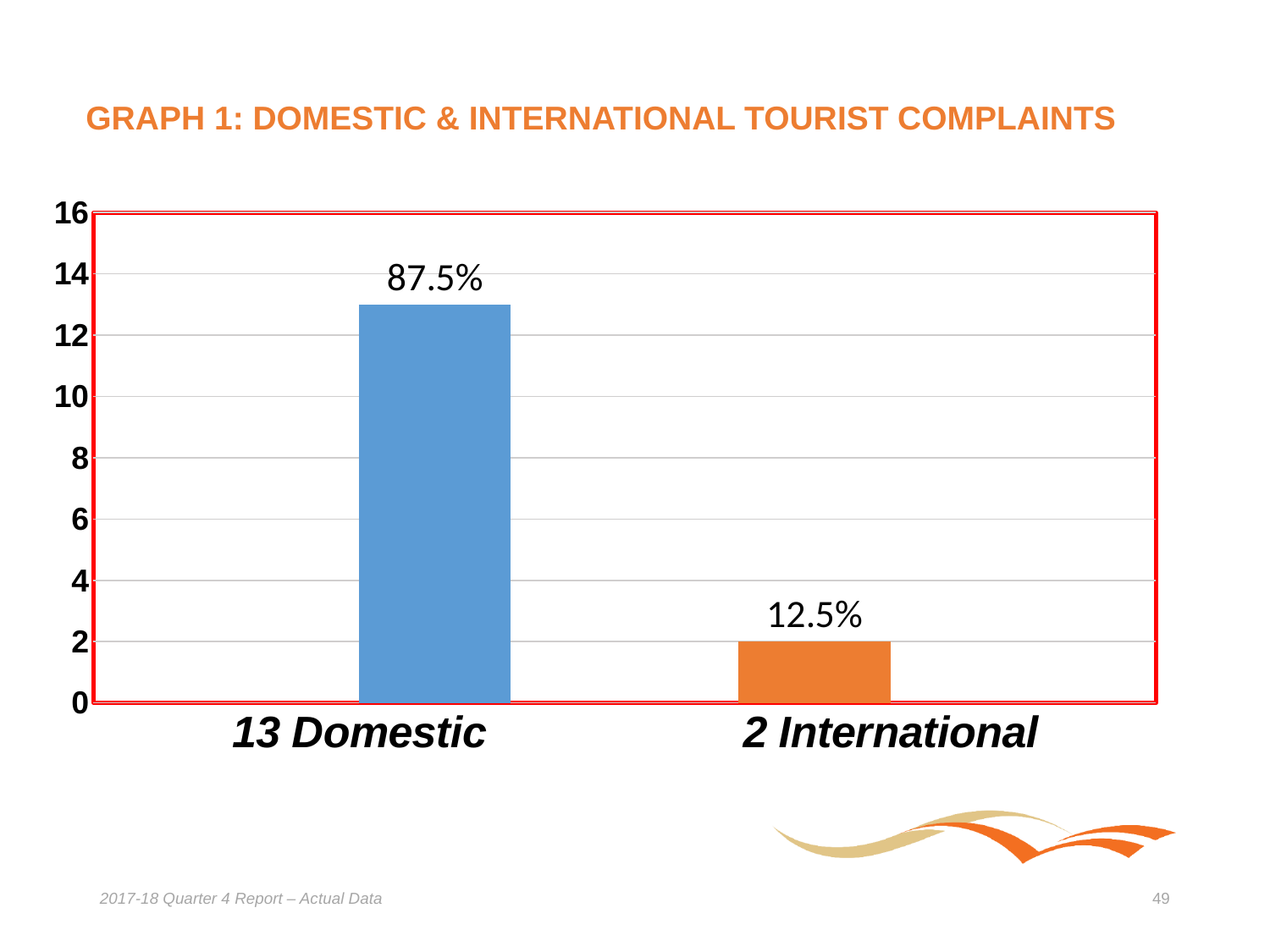
Which category has the highest bar? 13 Domestic What is the maximum value shown on the vertical axis? 16 Is the value for Domestic greater or less than 12? greater What is the data label shown on the Domestic bar? 87.5% Is the value for International greater or less than 4? less Which is larger, the Domestic bar or the International bar? Domestic Which category has the lowest bar? 2 International What kind of chart is shown on the slide? Bar chart What is the data label shown on the International bar? 12.5% How many categories are shown on the x axis? 2 What is the title of the chart? GRAPH 1: DOMESTIC & INTERNATIONAL TOURIST COMPLAINTS What is the difference in percentage points between the Domestic and International data labels? 75%